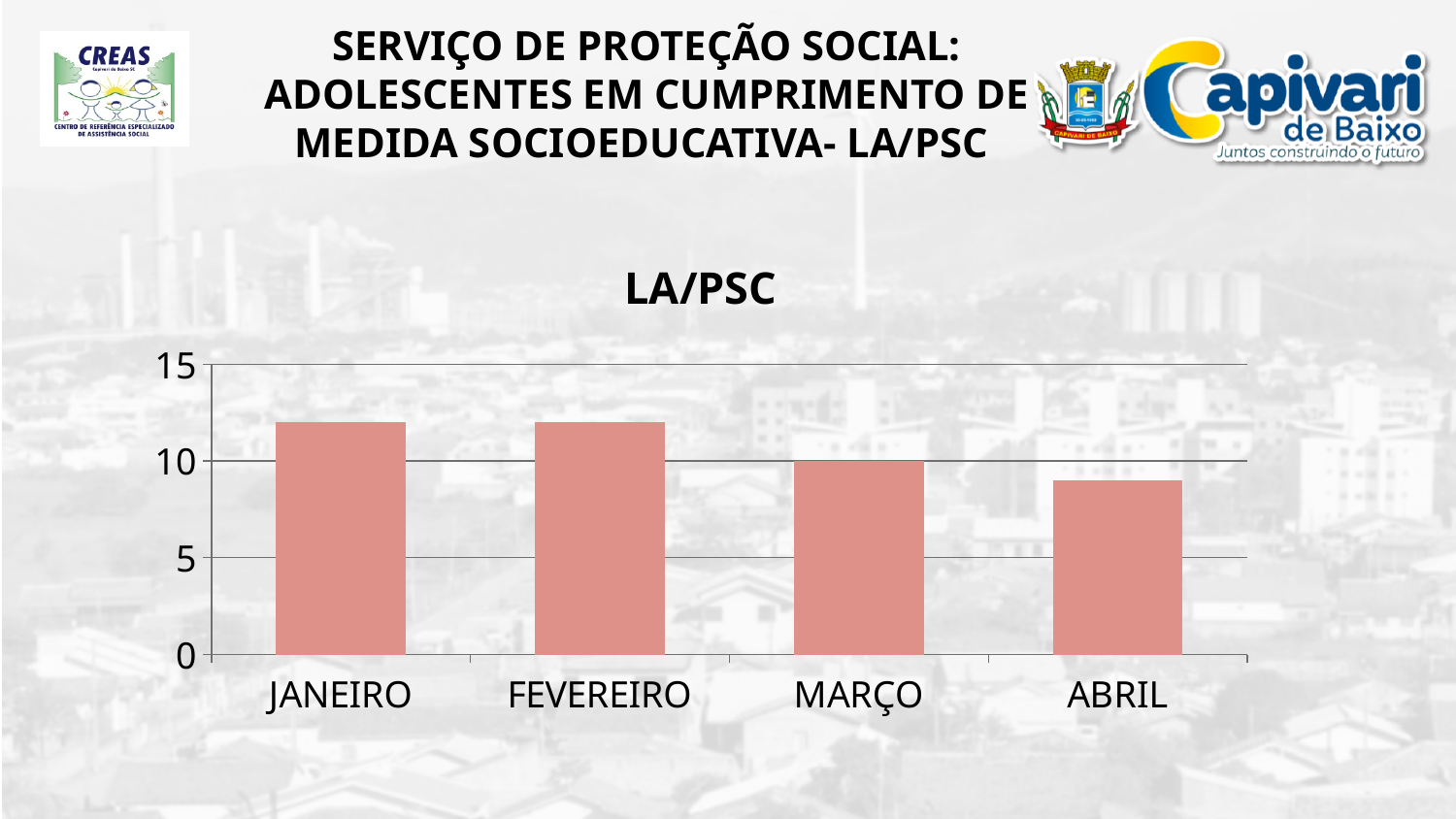
Which is larger, the value for JANEIRO or the value for ABRIL? JANEIRO What is the value for MARÇO? 10 How many months are shown on the x axis of the chart? 4 Which is larger, the value for FEVEREIRO or the value for MARÇO? FEVEREIRO What type of chart is shown on the slide? bar chart Is the value for ABRIL greater or less than 10? less What is the title of the chart? LA/PSC Is the value for FEVEREIRO greater or less than 15? less Which month has the lowest value? ABRIL Do the values rise or fall from JANEIRO to ABRIL? fall Which is larger, the value for MARÇO or the value for ABRIL? MARÇO Is the value for JANEIRO greater or less than 10? greater